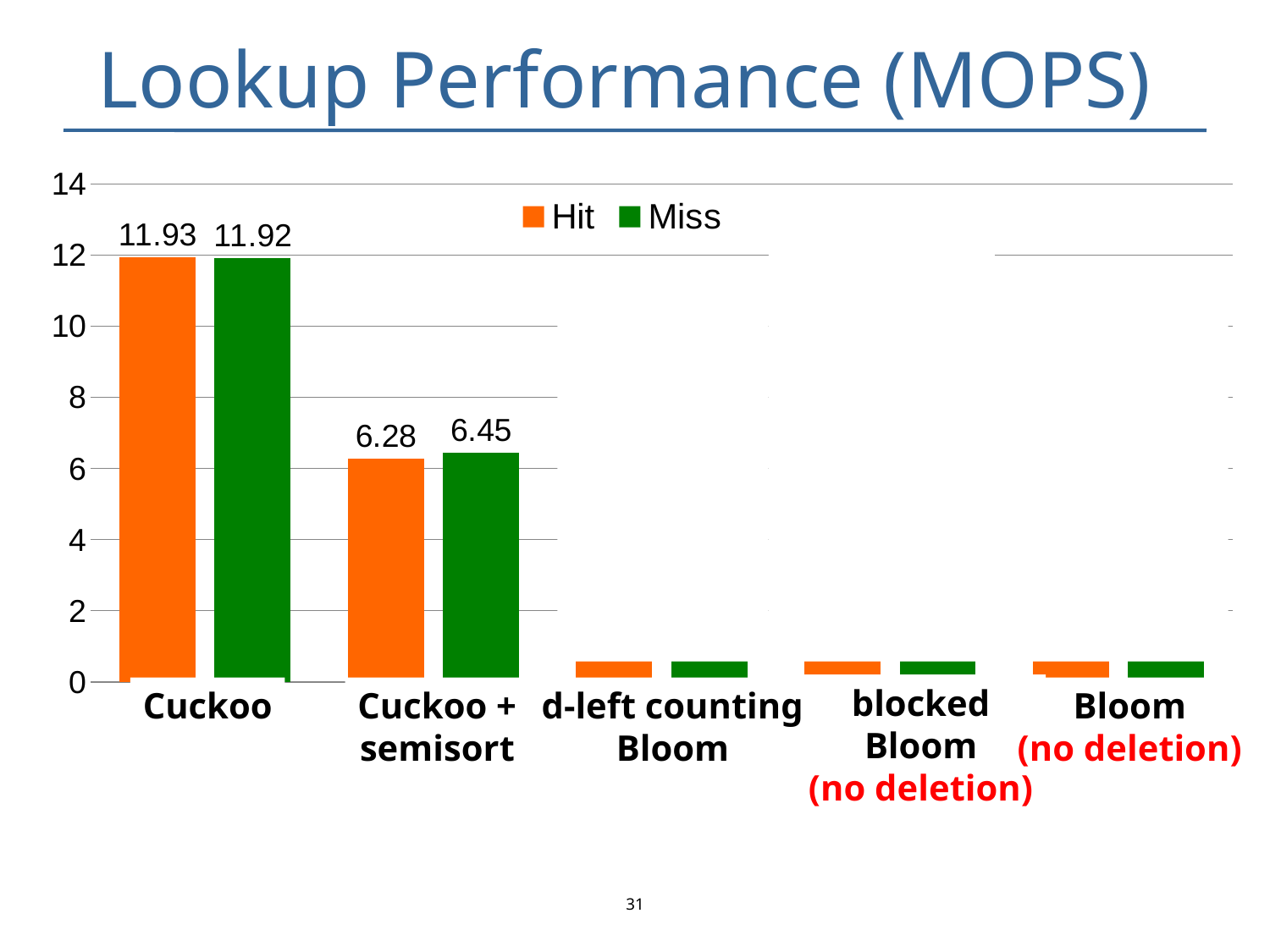
What is the Hit value for Cuckoo? 11.93 How many series does the legend list? 2 How many categories are shown on the x axis? 5 What is the difference between the Hit values for Cuckoo and Cuckoo + semisort? 5.65 Which is larger for Cuckoo + semisort, the Hit value or the Miss value? Miss What is the Miss value for Cuckoo? 11.92 What is the difference between the Miss and Hit values for Cuckoo + semisort? 0.17 What is the Miss value for Cuckoo + semisort? 6.45 Which category has the highest Hit value? Cuckoo What kind of chart is shown on the slide? bar chart What is the Hit value for Cuckoo + semisort? 6.28